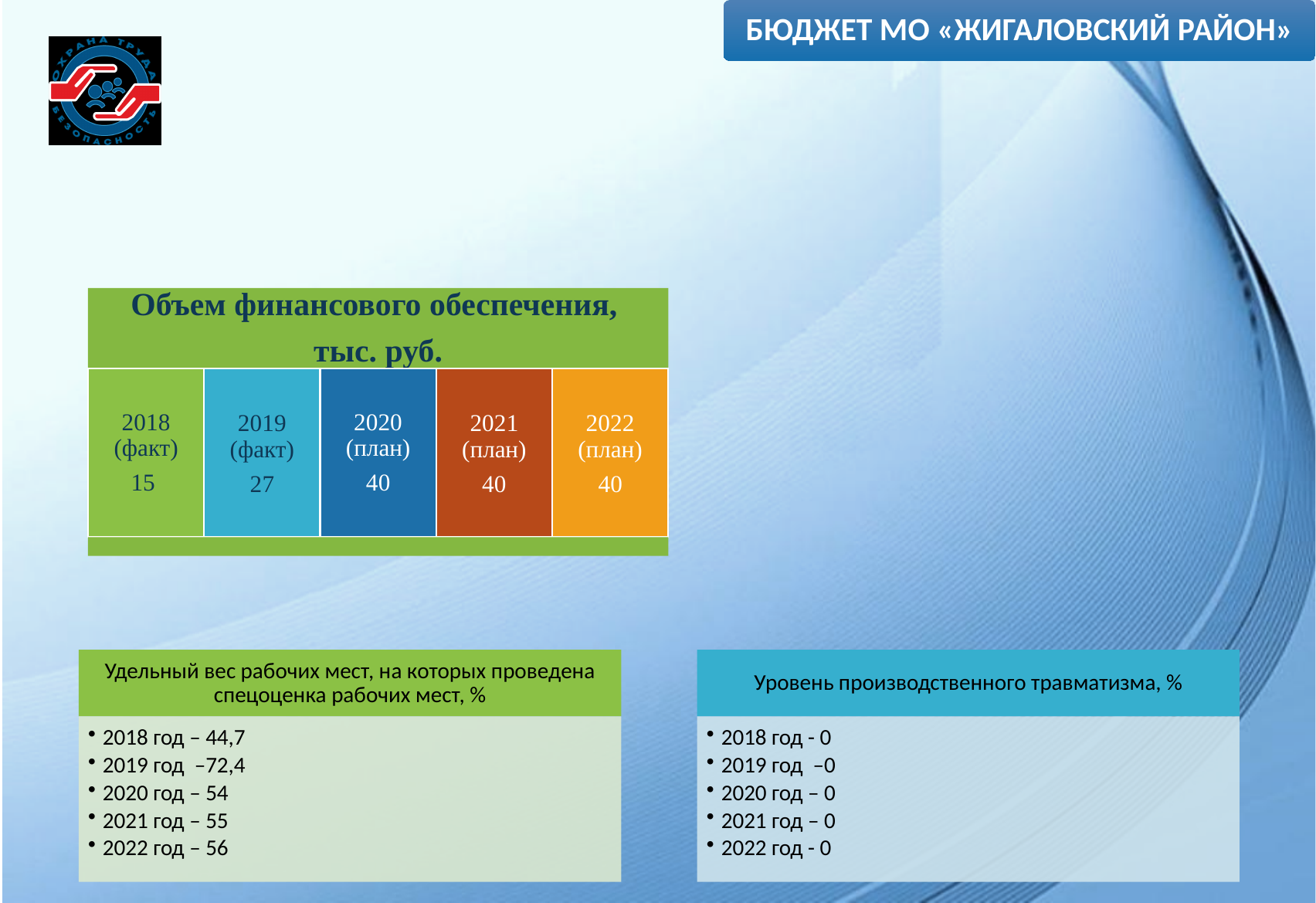
What is the title of the graphic showing values for 2018 through 2022? Объем финансового обеспечения, тыс. руб. How many year categories are shown in the 'Объем финансового обеспечения, тыс. руб.' graphic? 5 In the 'Объем финансового обеспечения, тыс. руб.' graphic, what is the value for 2020 (план)? 40 In the 'Объем финансового обеспечения, тыс. руб.' graphic, which is larger: the value for 2019 (факт) or 2018 (факт)? 2019 (факт) In the 'Объем финансового обеспечения, тыс. руб.' graphic, what is the difference between the 2019 (факт) and 2018 (факт) values? 12 In the 'Объем финансового обеспечения, тыс. руб.' graphic, what colour is the 2021 (план) block? Dark orange (brown-red) In the 'Объем финансового обеспечения, тыс. руб.' graphic, what is the difference between the 2020 (план) and 2019 (факт) values? 13 In the 'Объем финансового обеспечения, тыс. руб.' graphic, what is the value for 2022 (план)? 40 In the 'Объем финансового обеспечения, тыс. руб.' graphic, which year has the lowest value? 2018 (факт) In the 'Объем финансового обеспечения, тыс. руб.' graphic, what is the value for 2019 (факт)? 27 In the 'Объем финансового обеспечения, тыс. руб.' graphic, what is the value for 2018 (факт)? 15 In the 'Объем финансового обеспечения, тыс. руб.' graphic, do the values rise or fall from 2018 to 2020? rise